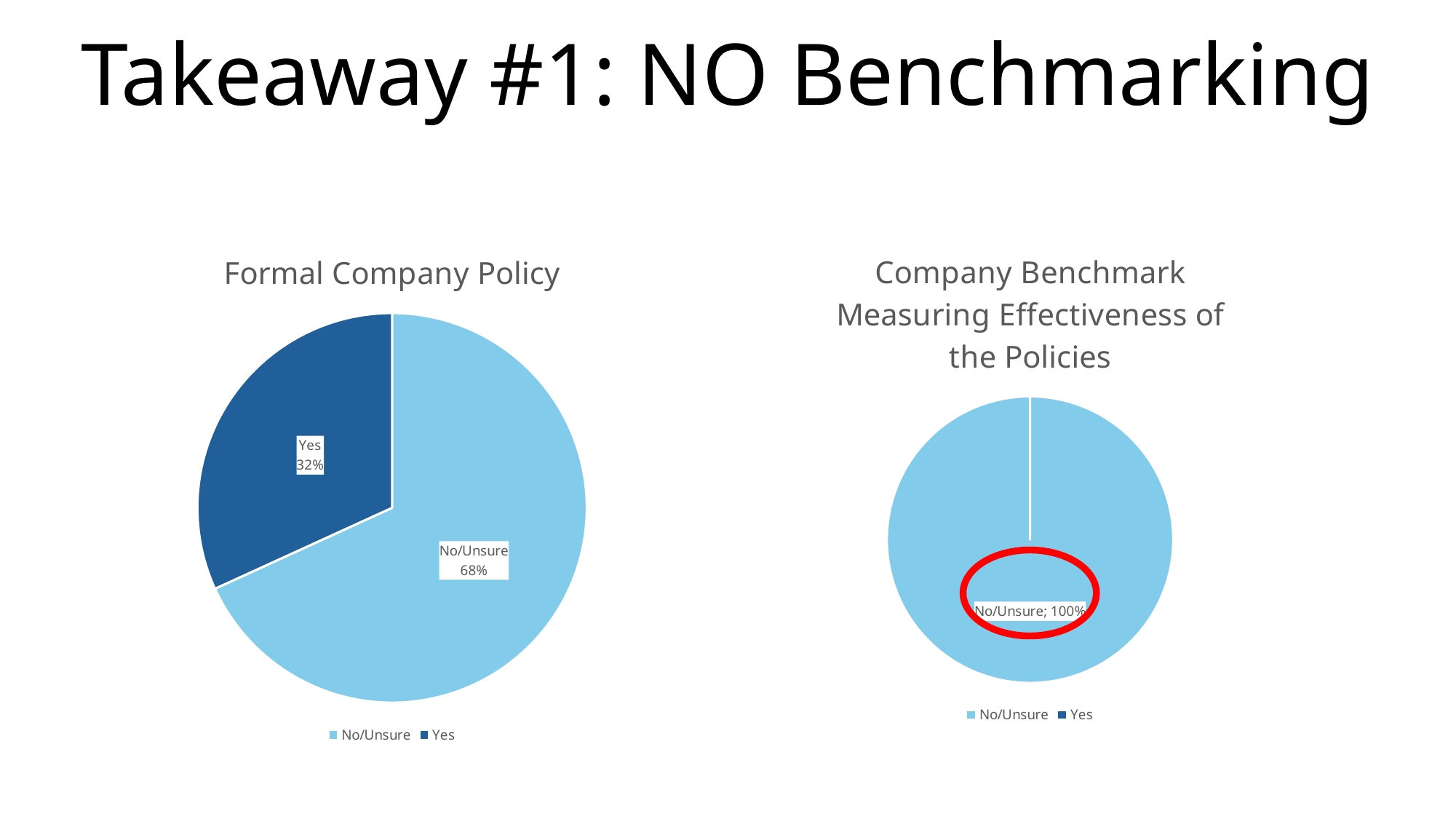
In the 'Formal Company Policy' chart, what colour is the 'Yes' slice? Dark blue What is the title of the chart on the left of the slide? Formal Company Policy In the 'Formal Company Policy' chart, which slice is the largest? No/Unsure In the 'Formal Company Policy' chart, which is larger, 'Yes' or 'No/Unsure'? No/Unsure In the 'Formal Company Policy' chart, what share of the pie is 'Yes'? 32% What kind of chart is the 'Formal Company Policy' chart? Pie chart In the 'Formal Company Policy' chart, which slice is the smallest? Yes In the 'Formal Company Policy' chart, what is the difference in percentage points between 'No/Unsure' and 'Yes'? 36 In the 'Company Benchmark Measuring Effectiveness of the Policies' chart, what share of the pie is 'No/Unsure'? 100% How many entries does the legend of the 'Formal Company Policy' chart list? 2 How many entries does the legend of the 'Company Benchmark Measuring Effectiveness of the Policies' chart list? 2 In the 'Formal Company Policy' chart, what share of the pie is 'No/Unsure'? 68%